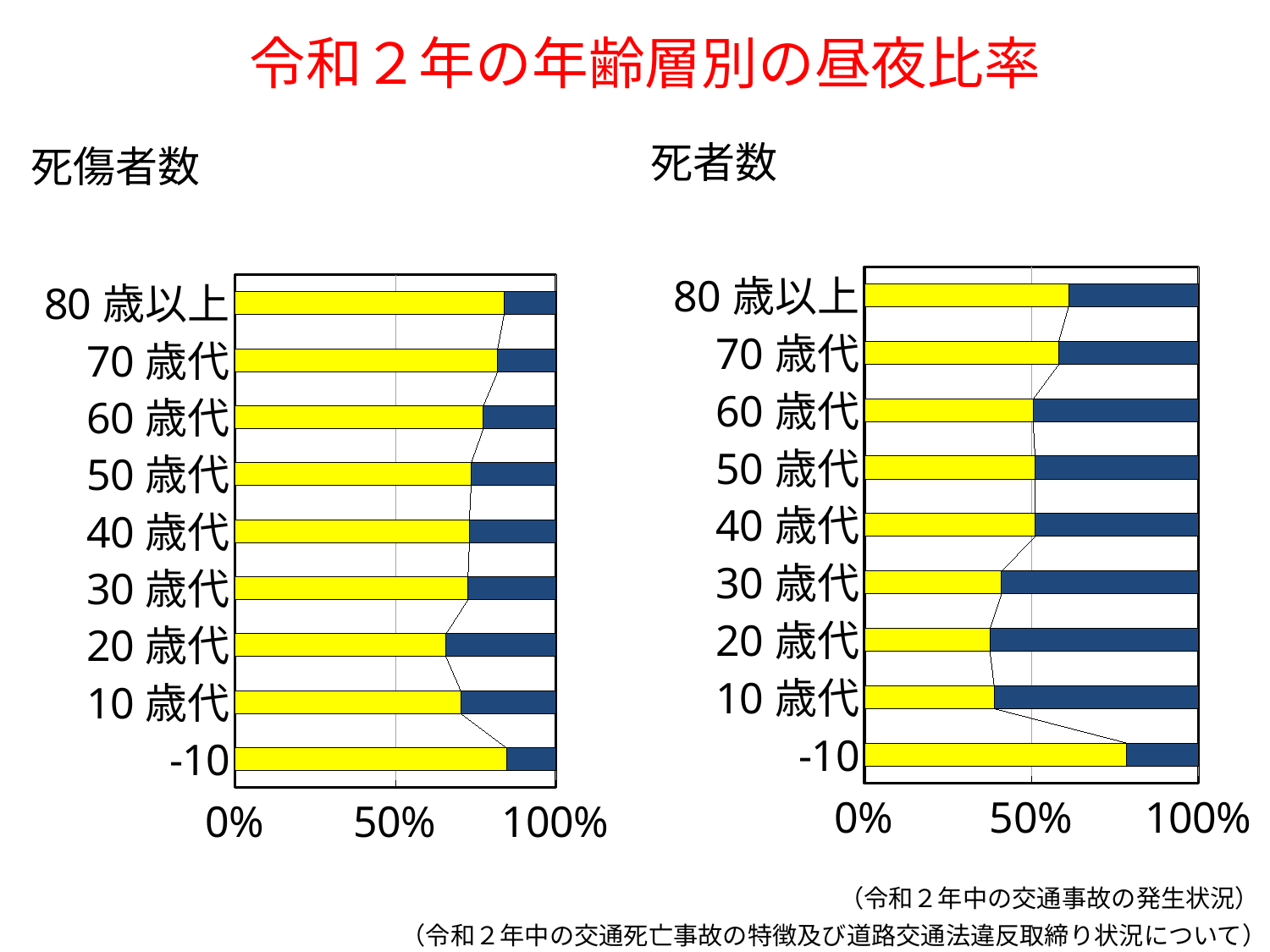
In the 死者数 chart on the right, is the yellow segment for 10歳代 greater or less than 50%? less What is the title of the slide's charts? 令和２年の年齢層別の昼夜比率 How many age categories are shown in the 死者数 chart on the right? 9 In the 死者数 chart on the right, is the yellow segment for -10 greater or less than 50%? greater In the 死者数 chart on the right, is the yellow segment for 20歳代 greater or less than 50%? less What two colours are used for the bar segments in the charts? yellow and dark blue How many age categories are shown in the 死傷者数 chart on the left? 9 In the 死者数 chart on the right, which age category has the longest yellow segment? -10 What kind of chart is the 死傷者数 chart on the left? bar chart In the 死傷者数 chart on the left, which age category has the shortest yellow segment? 20歳代 In the 死者数 chart on the right, which has the larger yellow segment, 80歳以上 or 30歳代? 80歳以上